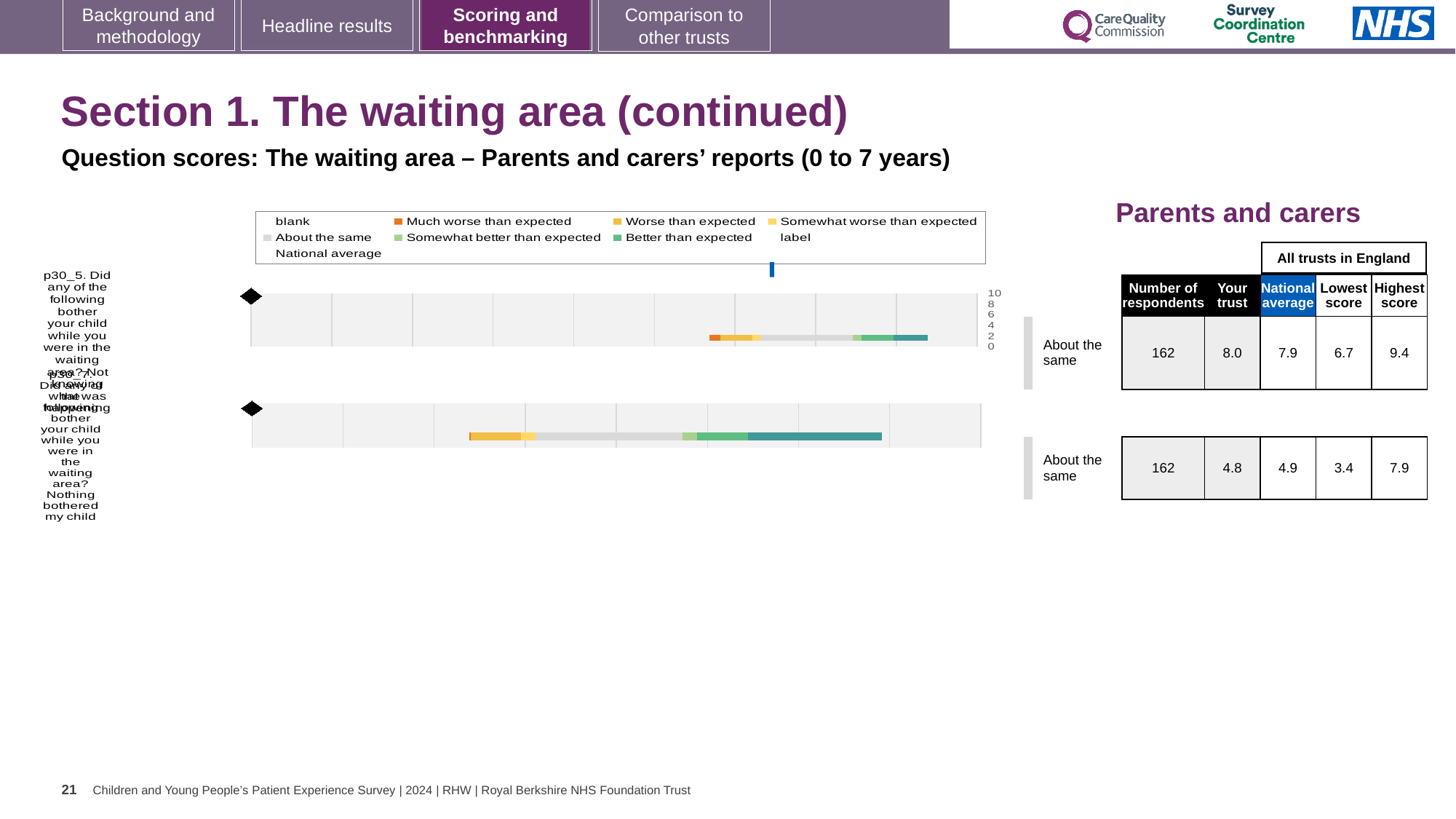
What colour does the legend use for 'Much worse than expected'? orange How many survey questions are plotted as bars on the slide? 2 How many entries does the chart legend list? 9 In the table next to the chart, what is the national average for question p30_7? 4.9 What benchmark rating is shown beside the bar for question p30_5? About the same In the table next to the chart, what is the 'Your trust' score for question p30_5? 8.0 For question p30_5, is the 'Your trust' score higher or lower than the national average? higher In the table next to the chart, what is the lowest score across all trusts in England for question p30_7? 3.4 For question p30_7, what is the difference between the highest score and the lowest score across all trusts in England? 4.5 What kind of chart is used to show the question scores on this slide? bar chart According to the legend, what does the dark blue marker on the chart represent? National average In the table next to the chart, what is the highest score across all trusts in England for question p30_5? 9.4